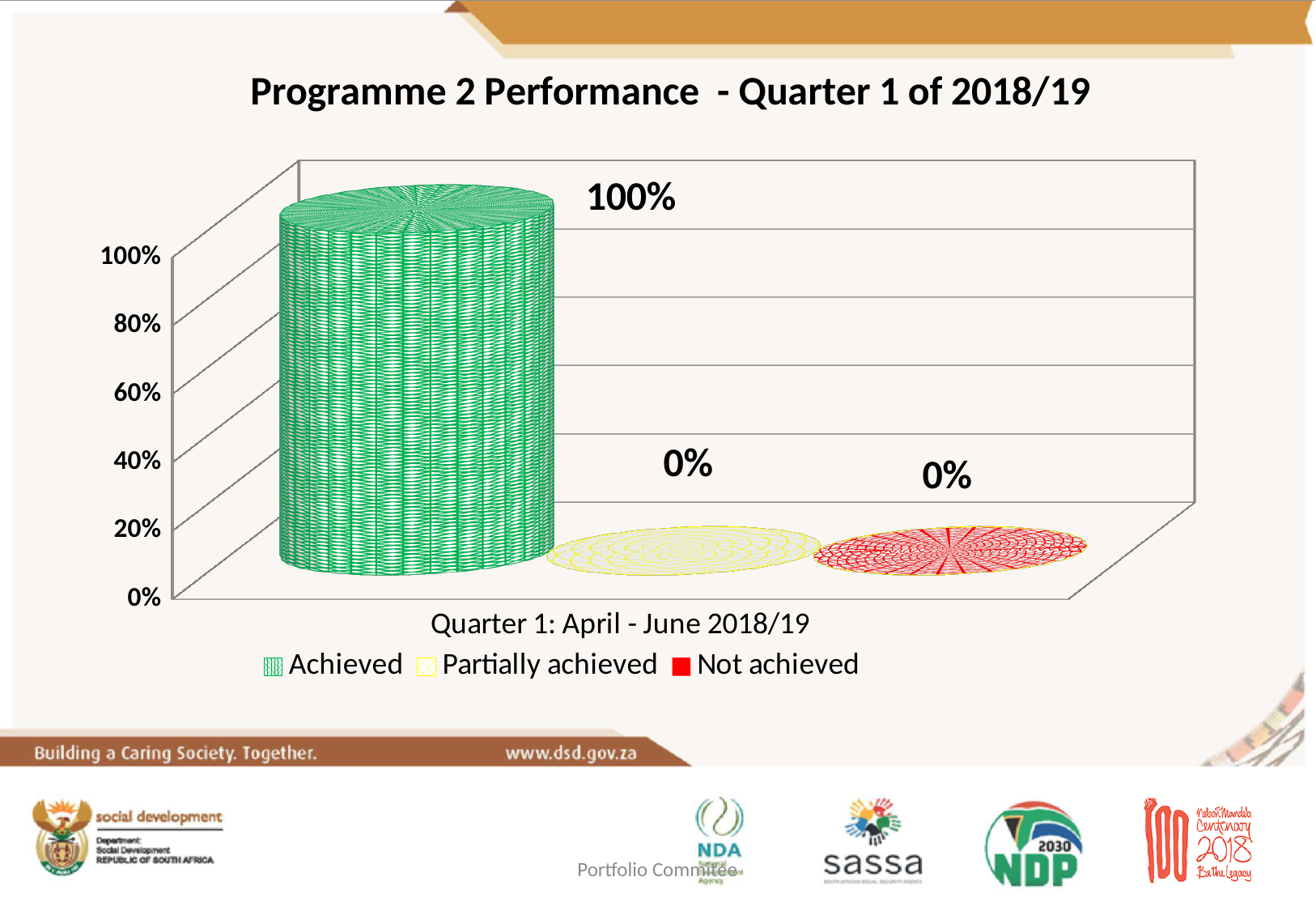
What is the value for Achieved in Quarter 1: April - June 2018/19? 100% How many categories are shown on the x axis? 1 What is the value for Partially achieved in Quarter 1: April - June 2018/19? 0% What is the title of the chart? Programme 2 Performance - Quarter 1 of 2018/19 What is the difference between the Achieved and Not achieved values? 100% Is the value for Achieved greater or less than 80%? greater Which is larger, the value for Achieved or the value for Partially achieved? Achieved What is the value for Not achieved in Quarter 1: April - June 2018/19? 0% What kind of chart is shown on the slide? Bar chart Which series has the highest value in the chart? Achieved How many series does the legend list? 3 What colour represents the Not achieved series in the legend? Red